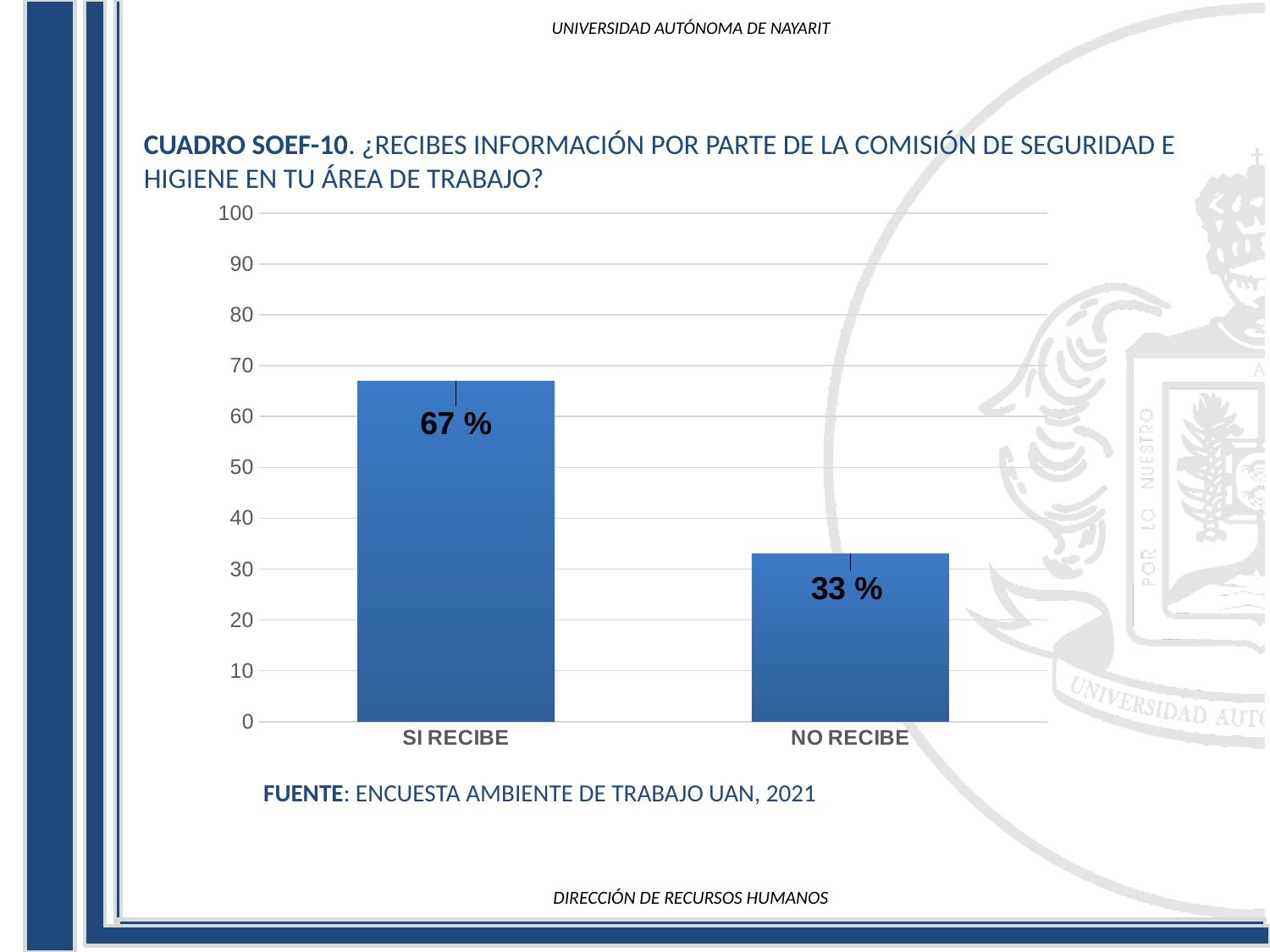
What kind of chart is shown on the slide? bar chart What is the source cited below the chart? ENCUESTA AMBIENTE DE TRABAJO UAN, 2021 Which category has the highest value? SI RECIBE What is the total of the two bar values? 100 % Is the value for SI RECIBE greater or less than 60? greater How many categories are shown on the x axis? 2 Is the value for NO RECIBE greater or less than 40? less Which is larger, the value for SI RECIBE or the value for NO RECIBE? SI RECIBE What is the value for NO RECIBE? 33 % What is the value for SI RECIBE? 67 % What is the difference between the values for SI RECIBE and NO RECIBE? 34 % Which category has the lowest value? NO RECIBE